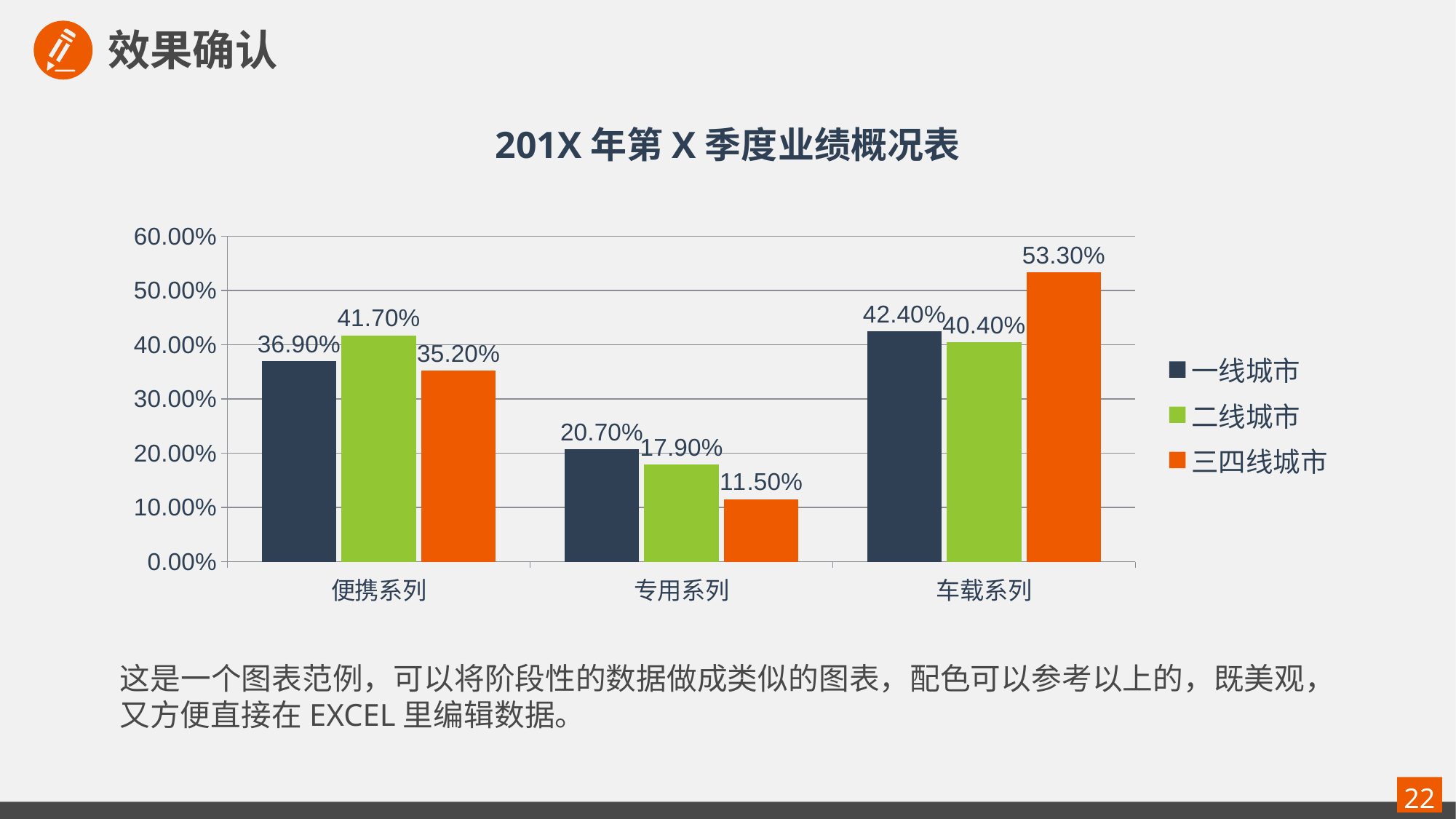
Which category has the highest value for 三四线城市? 车载系列 What is the value for 二线城市 in the 专用系列 category? 17.90% Is the value for 三四线城市 in the 车载系列 category greater or less than 50.00%? greater What is the title of the chart? 201X 年第 X 季度业绩概况表 What is the value for 一线城市 in the 便携系列 category? 36.90% What is the difference between the 二线城市 and 三四线城市 values in the 专用系列 category? 6.40% How many categories are shown on the x axis? 3 What kind of chart is shown on the slide? bar chart Which category has the lowest value for 一线城市? 专用系列 How many series does the legend list? 3 What is the value for 三四线城市 in the 车载系列 category? 53.30% In the 便携系列 category, which is larger: the value for 一线城市 or for 二线城市? 二线城市